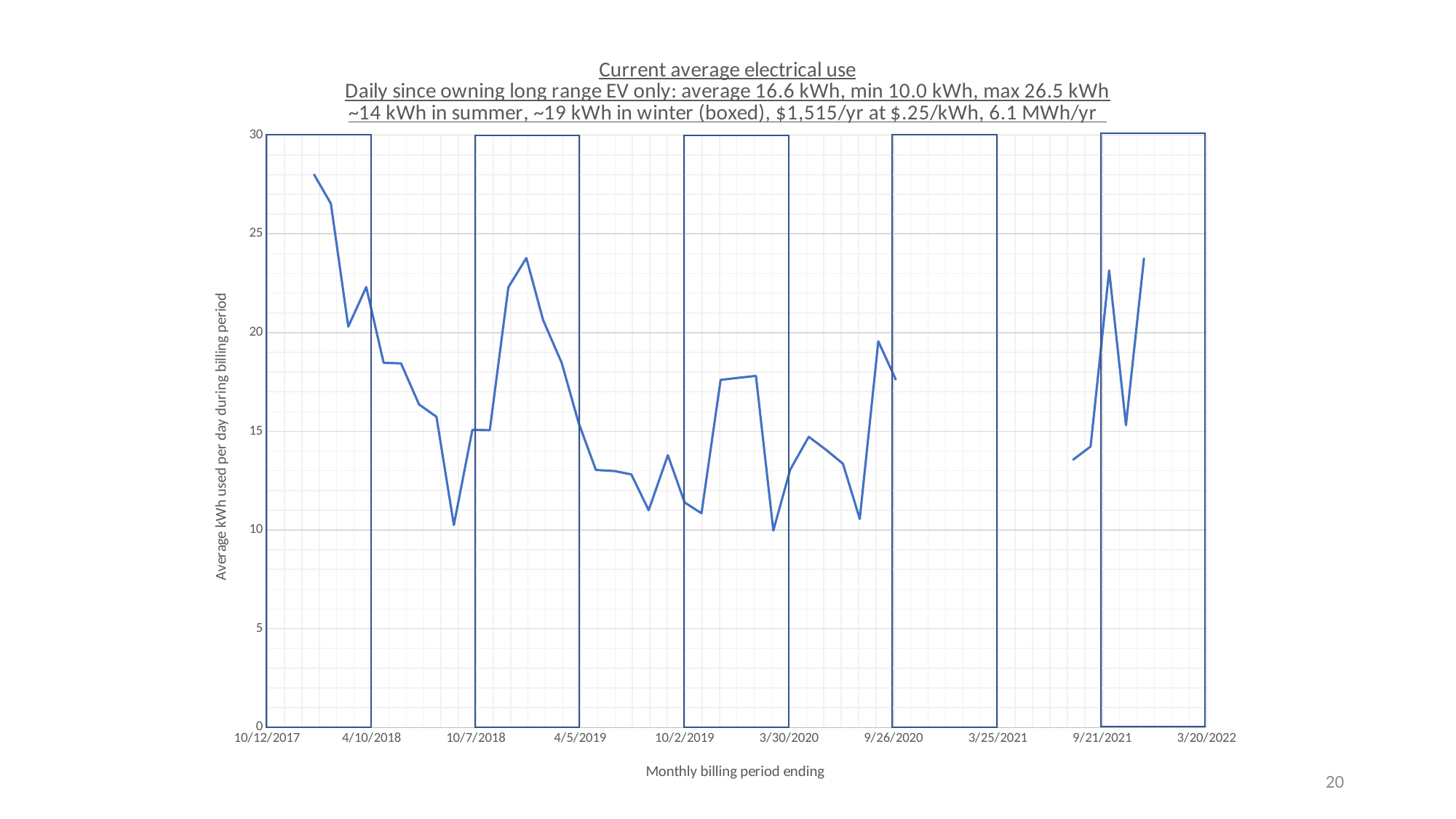
What is the title of the y axis? Average kWh used per day during billing period Is the highest point on the line greater or less than 25? greater Is the value at the billing period ending 3/30/2020 greater or less than 15? less What kind of chart is shown on the slide? line chart According to the chart title, what is the average daily electrical use since owning the long range EV only? 16.6 kWh Do the values generally rise or fall from the first point to the billing period ending 10/7/2018? fall According to the chart title, what is the maximum daily electrical use? 26.5 kWh What is the title of the x axis? Monthly billing period ending Is the last plotted value on the line greater or less than 20? greater According to the chart title, what is the minimum daily electrical use? 10.0 kWh According to the chart title, what is the annual electricity cost at $.25/kWh? $1,515/yr